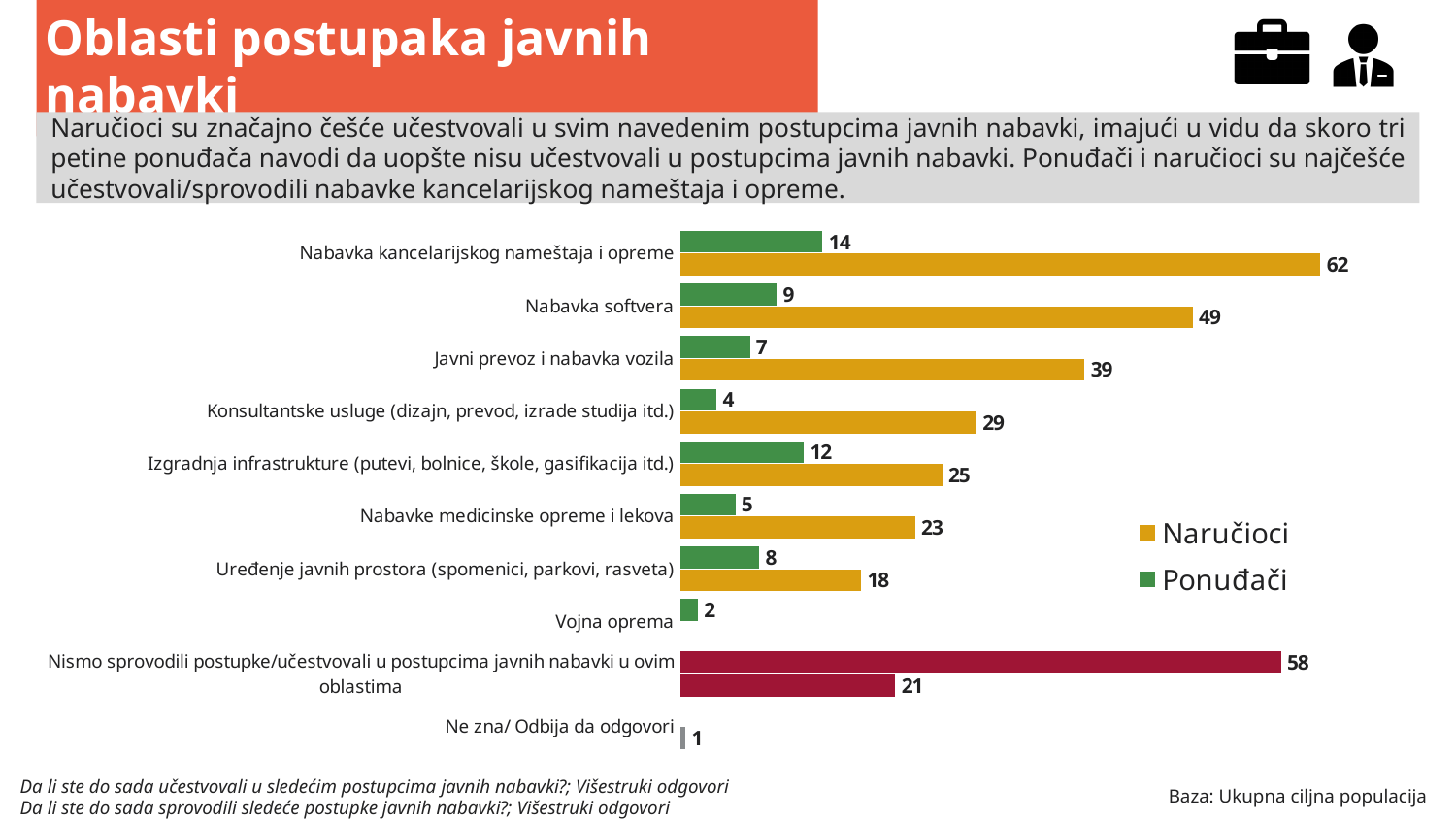
What is the value for Naručioci for 'Nabavka kancelarijskog nameštaja i opreme'? 62 What is the difference between the Naručioci and Ponuđači values for 'Nabavka softvera'? 40 What kind of chart is shown on the slide? bar chart Which category has the highest value for Naručioci? Nabavka kancelarijskog nameštaja i opreme Which is larger for 'Uređenje javnih prostora (spomenici, parkovi, rasveta)': the Naručioci value or the Ponuđači value? Naručioci Which category has the lowest value for Ponuđači among those with a green bar? Vojna oprema How many series does the legend list? 2 What is the value for Naručioci for 'Javni prevoz i nabavka vozila'? 39 What is the value shown for 'Ne zna/ Odbija da odgovori'? 1 What is the value for Ponuđači for 'Izgradnja infrastrukture (putevi, bolnice, škole, gasifikacija itd.)'? 12 Which colour represents the Ponuđači series in the legend? green What is the value for Ponuđači for 'Nabavka softvera'? 9